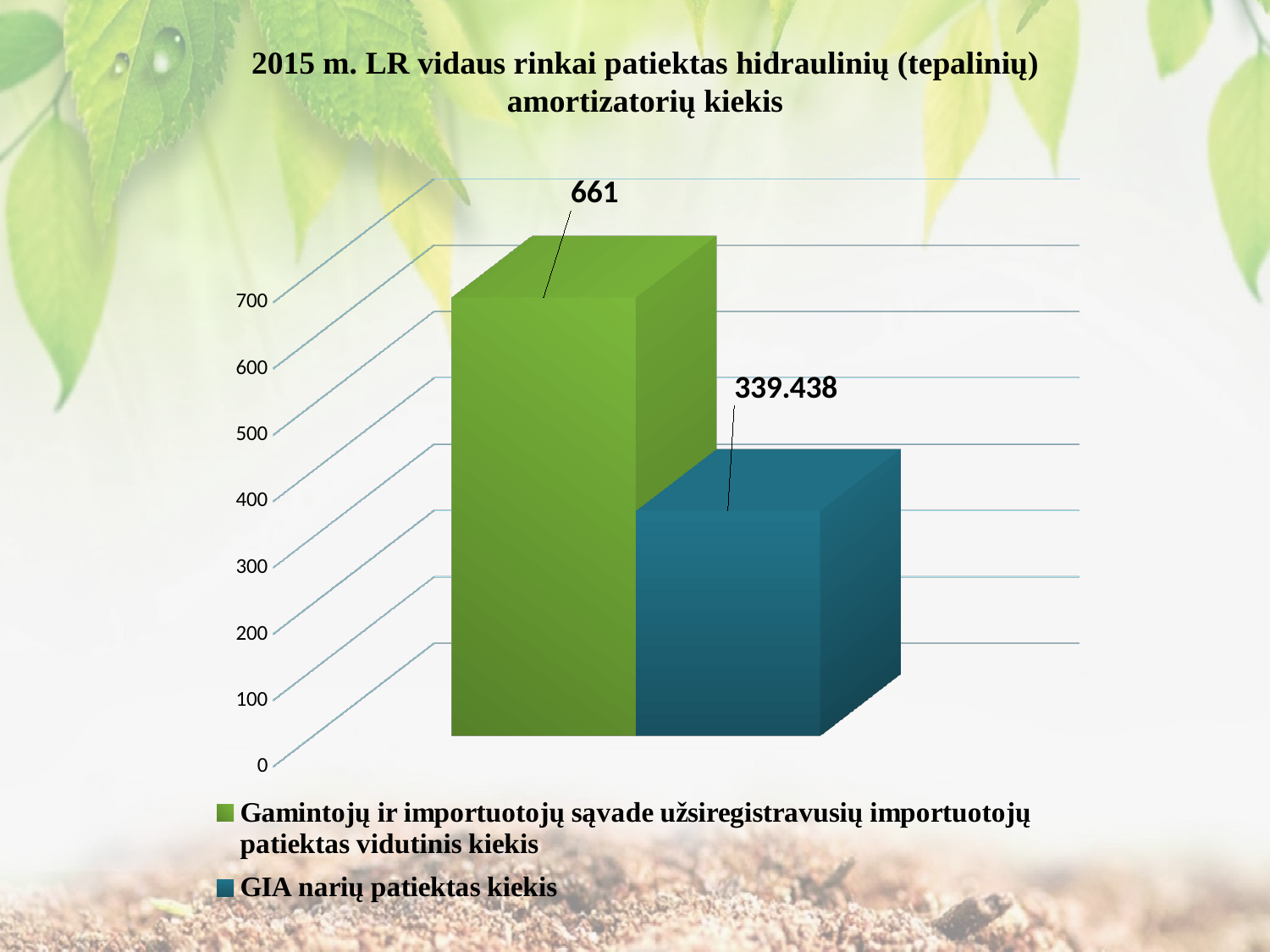
What colour is the bar for 'GIA narių patiektas kiekis'? blue How many series does the legend list? 2 Which is larger: the value for 'GIA narių patiektas kiekis' or the value for 'Gamintojų ir importuotojų sąvade užsiregistravusių importuotojų patiektas vidutinis kiekis'? Gamintojų ir importuotojų sąvade užsiregistravusių importuotojų patiektas vidutinis kiekis What is the difference between the value for 'Gamintojų ir importuotojų sąvade užsiregistravusių importuotojų patiektas vidutinis kiekis' and the value for 'GIA narių patiektas kiekis'? 321.562 What kind of chart is shown on the slide? bar chart Which series has the highest value? Gamintojų ir importuotojų sąvade užsiregistravusių importuotojų patiektas vidutinis kiekis What value is shown for 'Gamintojų ir importuotojų sąvade užsiregistravusių importuotojų patiektas vidutinis kiekis'? 661 What value is shown for 'GIA narių patiektas kiekis'? 339.438 Is the value for 'Gamintojų ir importuotojų sąvade užsiregistravusių importuotojų patiektas vidutinis kiekis' greater or less than 600? greater How many bars are plotted on the chart? 2 Is the value for 'GIA narių patiektas kiekis' greater or less than 400? less Which series has the lowest value? GIA narių patiektas kiekis